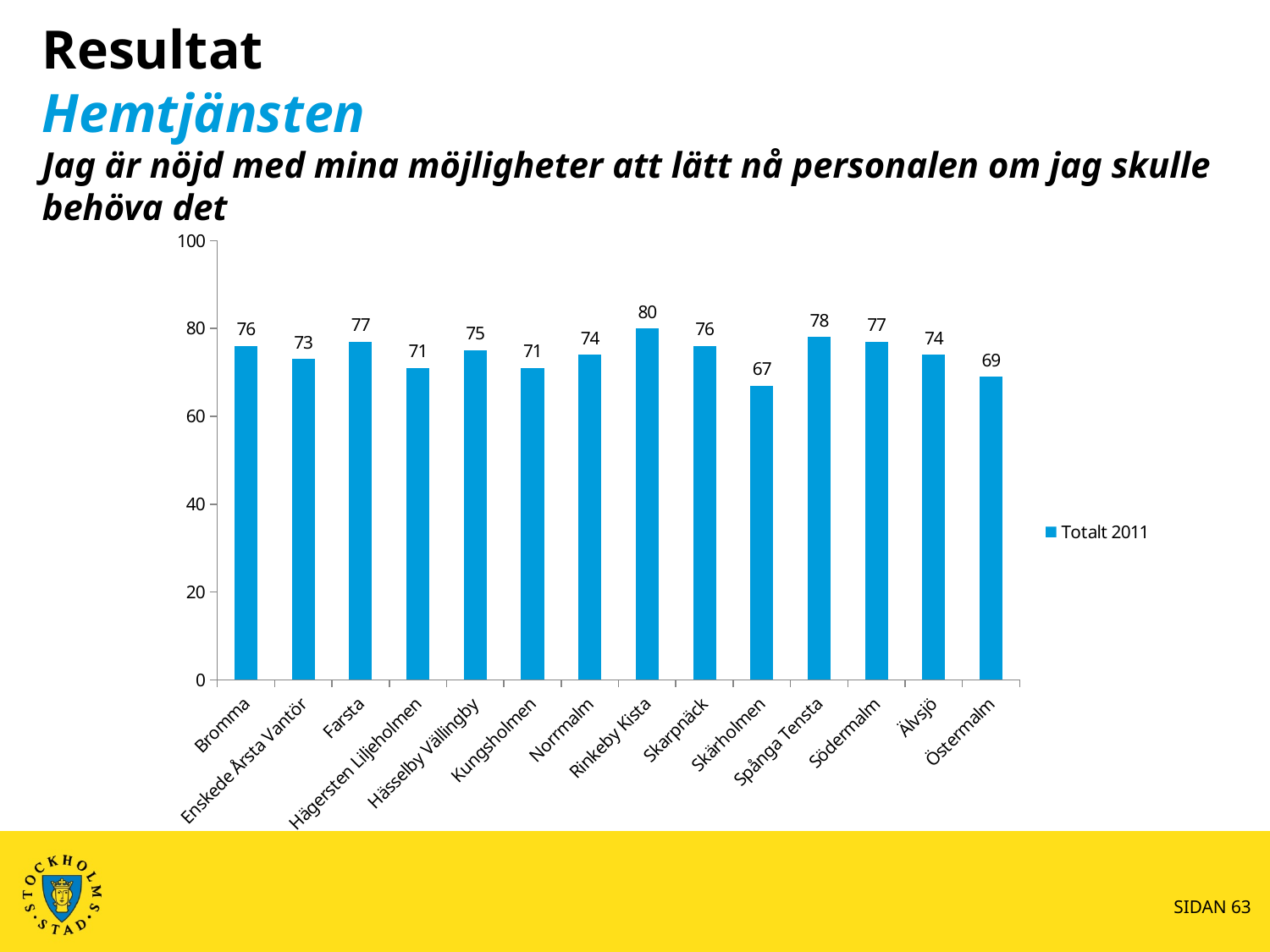
What is the legend entry for the series? Totalt 2011 What kind of chart is shown? bar chart Is the value for Hässelby Vällingby greater or less than 60? greater Which category has the highest value? Rinkeby Kista What is the value for Skärholmen? 67 What is the value for Bromma? 76 What is the difference between the values for Rinkeby Kista and Skärholmen? 13 What is the value for Spånga Tensta? 78 Which is larger, the value for Farsta or the value for Östermalm? Farsta Which category has the lowest value? Skärholmen How many series does the legend list? 1 How many categories are shown on the x axis? 14